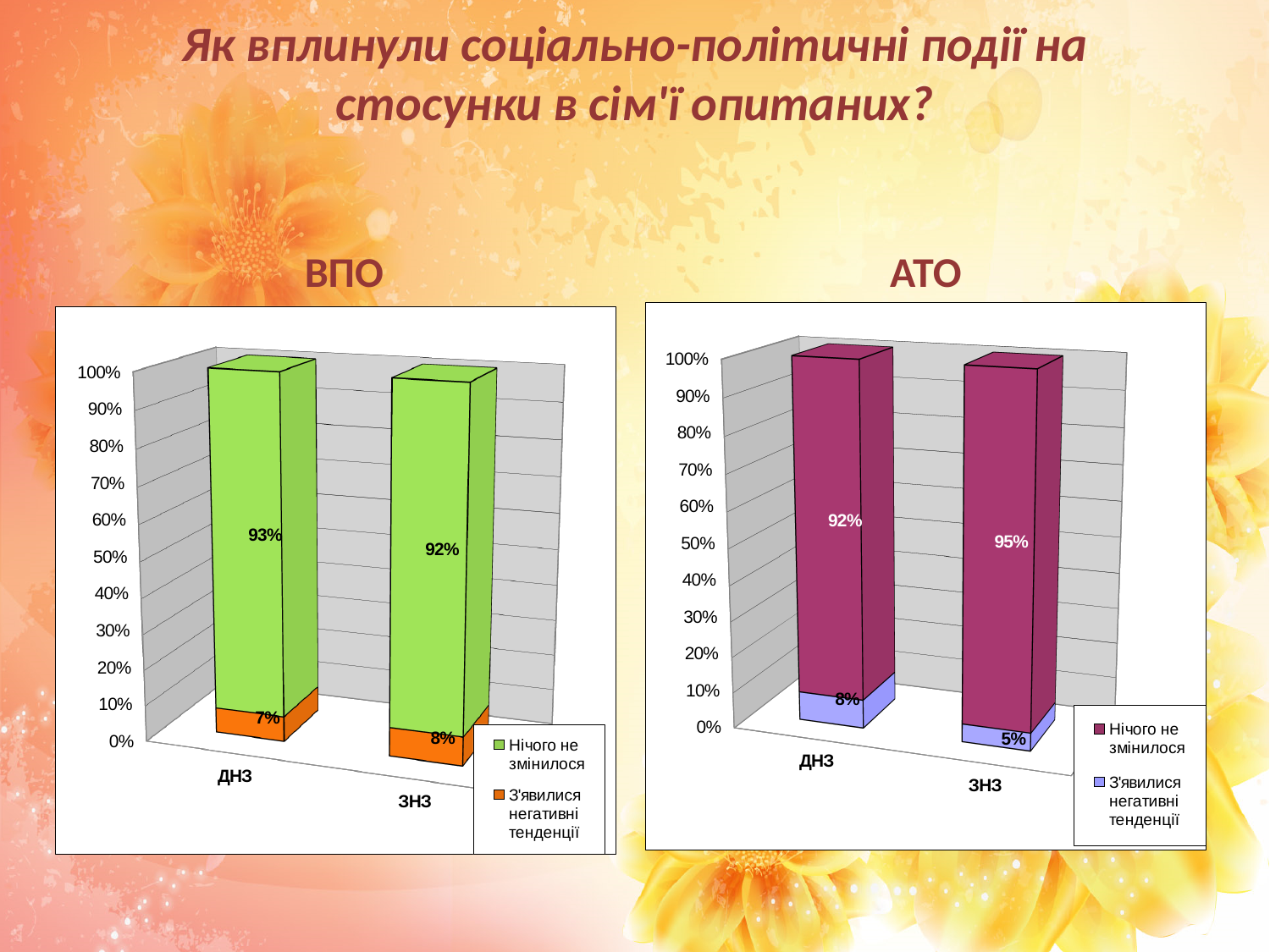
In the АТО chart, what is the value of "Нічого не змінилося" for ЗНЗ? 95% How many series does the legend of the ВПО chart list? 2 In the АТО chart, what is the value of "З'явилися негативні тенденції" for ДНЗ? 8% In the АТО chart, which category has the higher value for "Нічого не змінилося"? ЗНЗ In the ВПО chart, is the "Нічого не змінилося" value larger for ДНЗ or for ЗНЗ? ДНЗ In the АТО chart, what is the difference between the "Нічого не змінилося" values for ЗНЗ and ДНЗ? 3% In the ВПО chart, which category has the lower value for "З'явилися негативні тенденції"? ДНЗ In the ВПО chart, what is the value of "З'явилися негативні тенденції" for ЗНЗ? 8% In the ВПО chart, what is the value of "Нічого не змінилося" for ДНЗ? 93% How many categories are shown on the x axis of the АТО chart? 2 In the АТО chart, what is the total of the stacked bar for ЗНЗ? 100% What kind of chart is the ВПО chart? Stacked bar chart